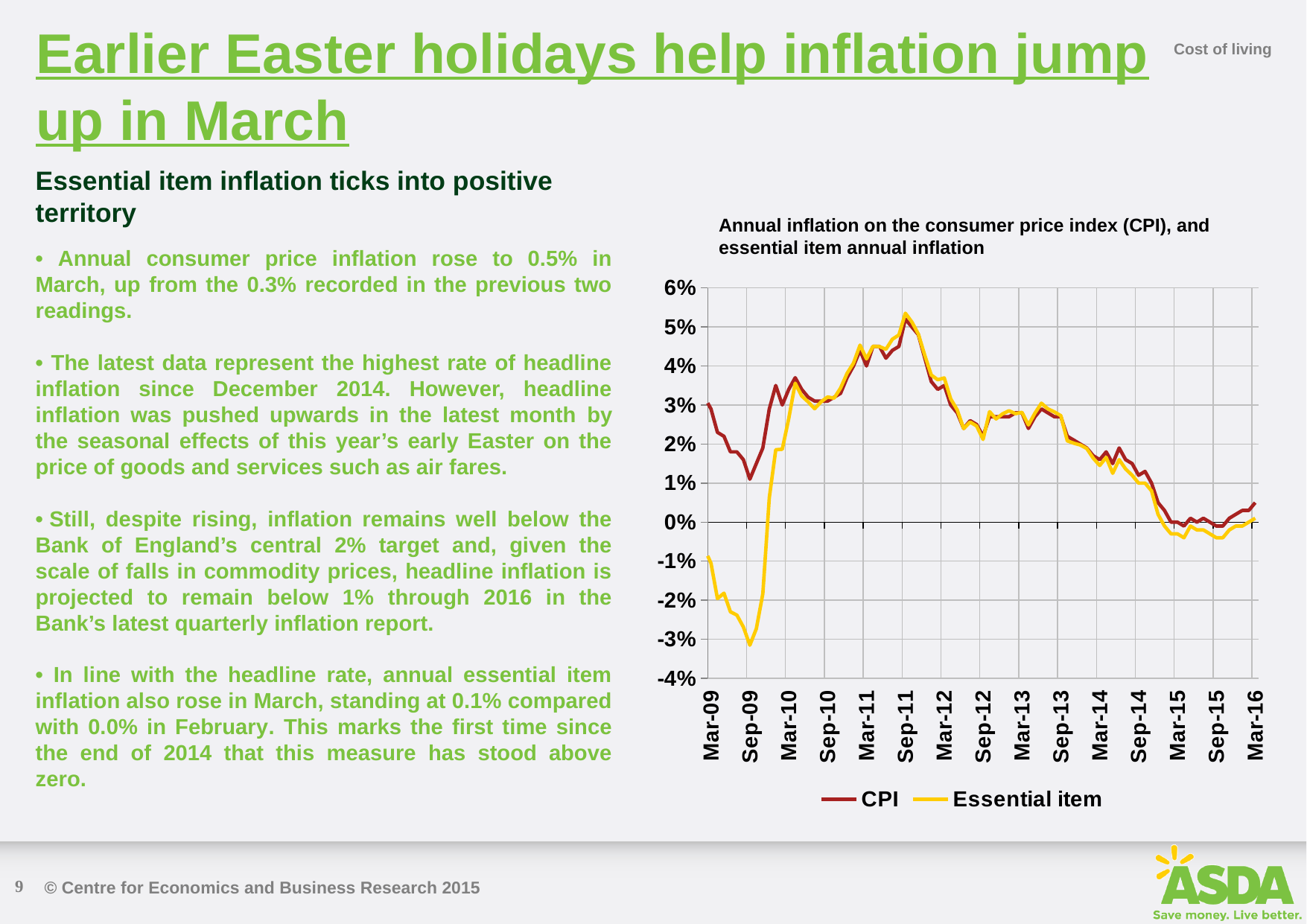
At Sep-09, which series has the higher value, CPI or Essential item? CPI How many date labels are shown along the x axis of the chart? 15 Which series reaches the lowest point anywhere on the chart? Essential item What kind of chart is shown on the slide? Line chart What colour is the Essential item line in the chart? Yellow Is the CPI value at Sep-11 greater or less than 4%? greater What are the two series named in the chart's legend? CPI and Essential item Is the Essential item value at Sep-09 greater or less than -2%? less Is the Essential item value at Mar-09 greater or less than 0%? less How many series does the chart's legend list? 2 Does the CPI line generally rise or fall between Sep-11 and Mar-15? Fall